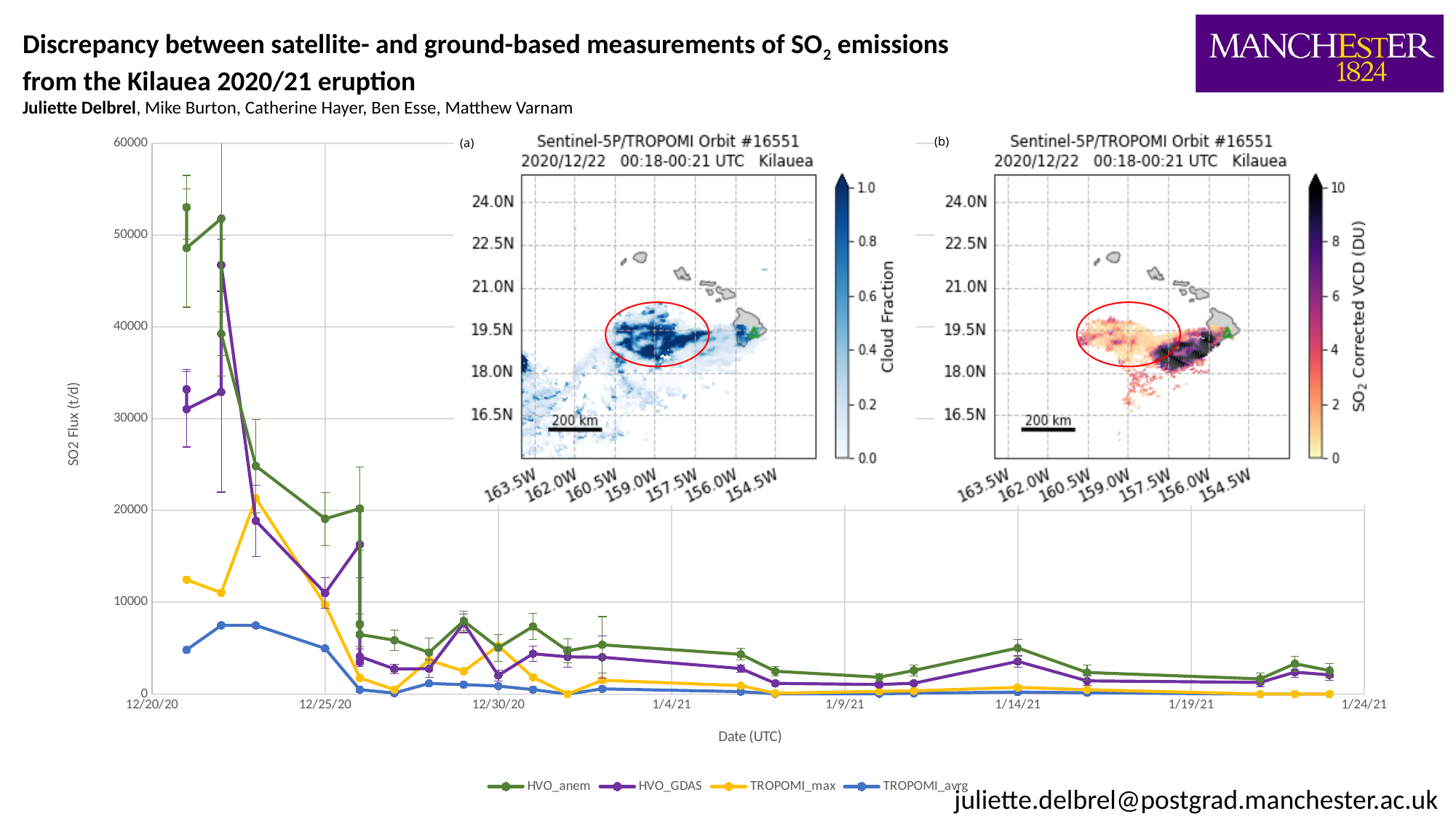
In the SO2 flux line chart, is the highest TROPOMI_avrg value greater or less than 10000? less In the SO2 flux line chart, which series reaches the highest SO2 flux value? HVO_anem In the SO2 flux line chart, which is larger at 12/25/20: HVO_anem or TROPOMI_avrg? HVO_anem What is the y-axis label of the SO2 flux line chart? SO2 Flux (t/d) In the SO2 flux line chart, is the highest TROPOMI_max value greater or less than 10000? greater In the SO2 flux line chart, which series has the lowest values across the period? TROPOMI_avrg In the SO2 flux line chart, is the first HVO_anem value (just after 12/20/20) greater or less than 40000? greater What kind of chart is the large chart on the left of the slide? line chart In the SO2 flux line chart, do the HVO_anem values overall rise or fall from 12/20/20 to 1/24/21? fall How many series does the legend of the SO2 flux line chart list? 4 What are the four series named in the legend of the SO2 flux line chart? HVO_anem, HVO_GDAS, TROPOMI_max, TROPOMI_avrg